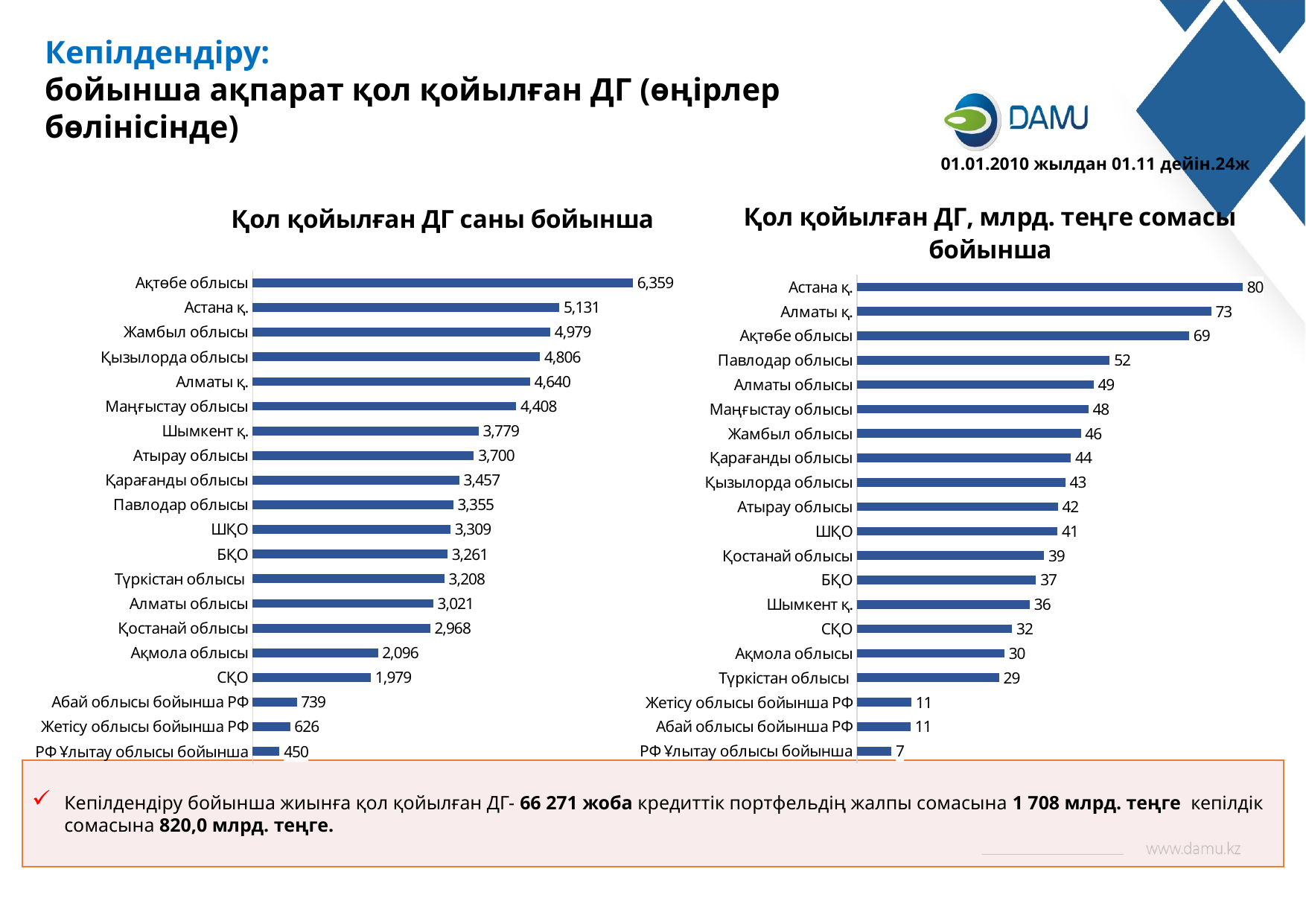
In the chart 'Қол қойылған ДГ саны бойынша', which is larger: Қарағанды облысы or Павлодар облысы? Қарағанды облысы In the chart 'Қол қойылған ДГ, млрд. теңге сомасы бойынша', what is the value for РФ Ұлытау облысы бойынша? 7 In the chart 'Қол қойылған ДГ, млрд. теңге сомасы бойынша', which category has the highest value? Астана қ. In the chart 'Қол қойылған ДГ саны бойынша', how many categories are shown? 20 In the chart 'Қол қойылған ДГ, млрд. теңге сомасы бойынша', which is larger: Алматы қ. or Ақтөбе облысы? Алматы қ. In the chart 'Қол қойылған ДГ, млрд. теңге сомасы бойынша', what is the difference between Астана қ. and Түркістан облысы? 51 What type of chart is 'Қол қойылған ДГ саны бойынша'? Bar chart In the chart 'Қол қойылған ДГ саны бойынша', what is the value for Ақтөбе облысы? 6,359 In the chart 'Қол қойылған ДГ саны бойынша', what is the difference between Астана қ. and Алматы қ.? 491 In the chart 'Қол қойылған ДГ саны бойынша', which category has the lowest value? РФ Ұлытау облысы бойынша In the chart 'Қол қойылған ДГ, млрд. теңге сомасы бойынша', what is the value for Павлодар облысы? 52 In the chart 'Қол қойылған ДГ саны бойынша', what is the value for Шымкент қ.? 3,779